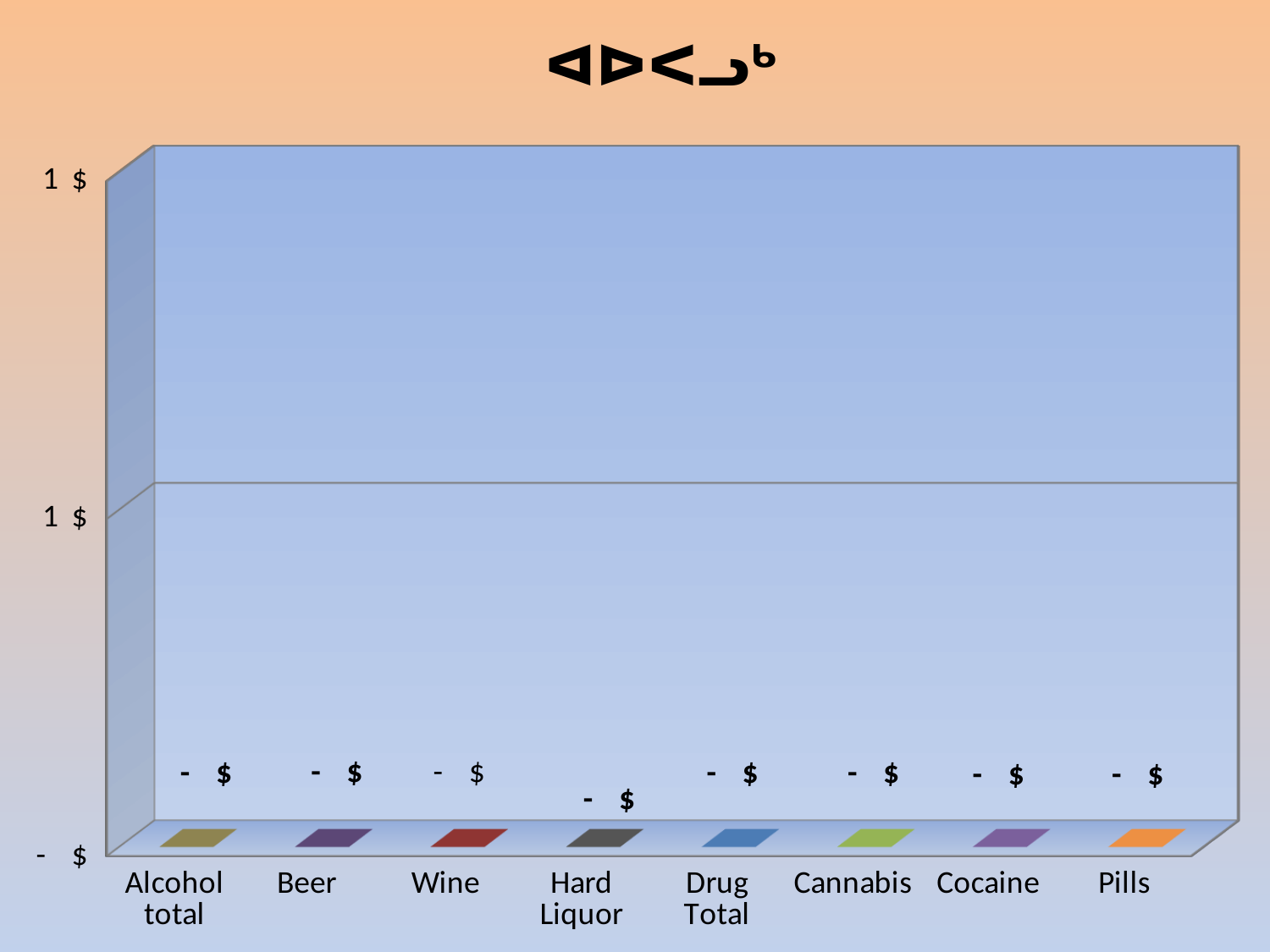
What value is labelled for Hard Liquor? - $ What value is labelled for Drug Total? - $ What kind of chart is shown on the slide? bar chart What value is labelled for Wine? - $ What value is labelled for Cocaine? - $ Which category is listed first on the x axis? Alcohol total How many categories are shown along the x axis of the chart? 8 What value is labelled for Cannabis? - $ What value is labelled for Pills? - $ What value is labelled for Alcohol total? - $ Which category is listed last on the x axis? Pills What value is labelled for Beer? - $